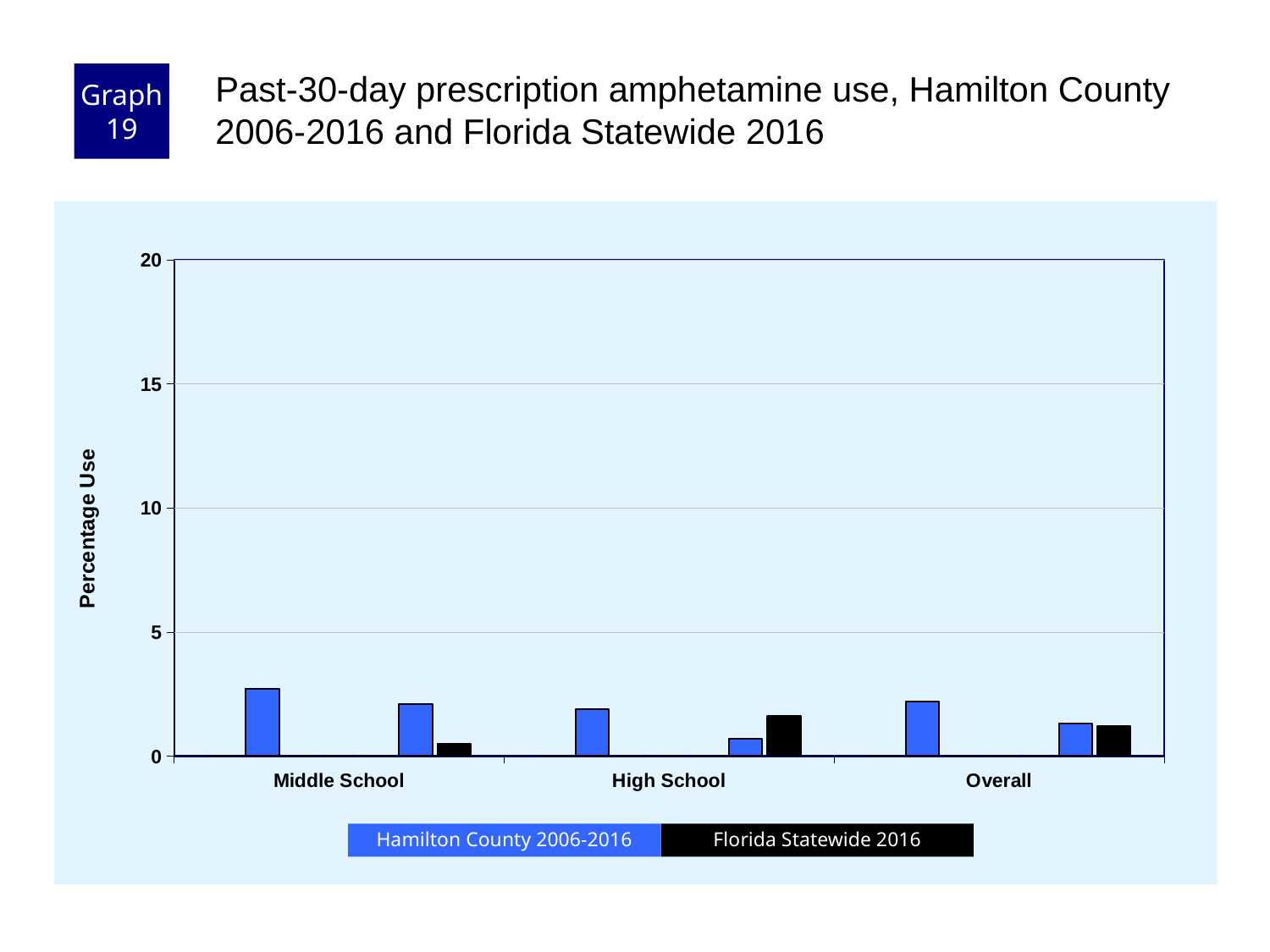
Is the Florida Statewide 2016 value for High School greater or less than 5? less What is the label on the y axis of the chart? Percentage Use Among the Florida Statewide 2016 bars, which category has the highest value? High School How many series does the chart legend list? 2 Is the Florida Statewide 2016 value larger for Middle School or for High School? High School Are any of the bars in the chart greater than 10? No What kind of chart is shown on the slide? bar chart What is the highest value shown on the y axis of the chart? 20 Among the Florida Statewide 2016 bars, which category has the lowest value? Middle School For Middle School, is the Florida Statewide 2016 bar taller or shorter than the Hamilton County bars? shorter How many categories are shown on the x axis of the chart? 3 Is the Florida Statewide 2016 value for Middle School greater or less than 5? less